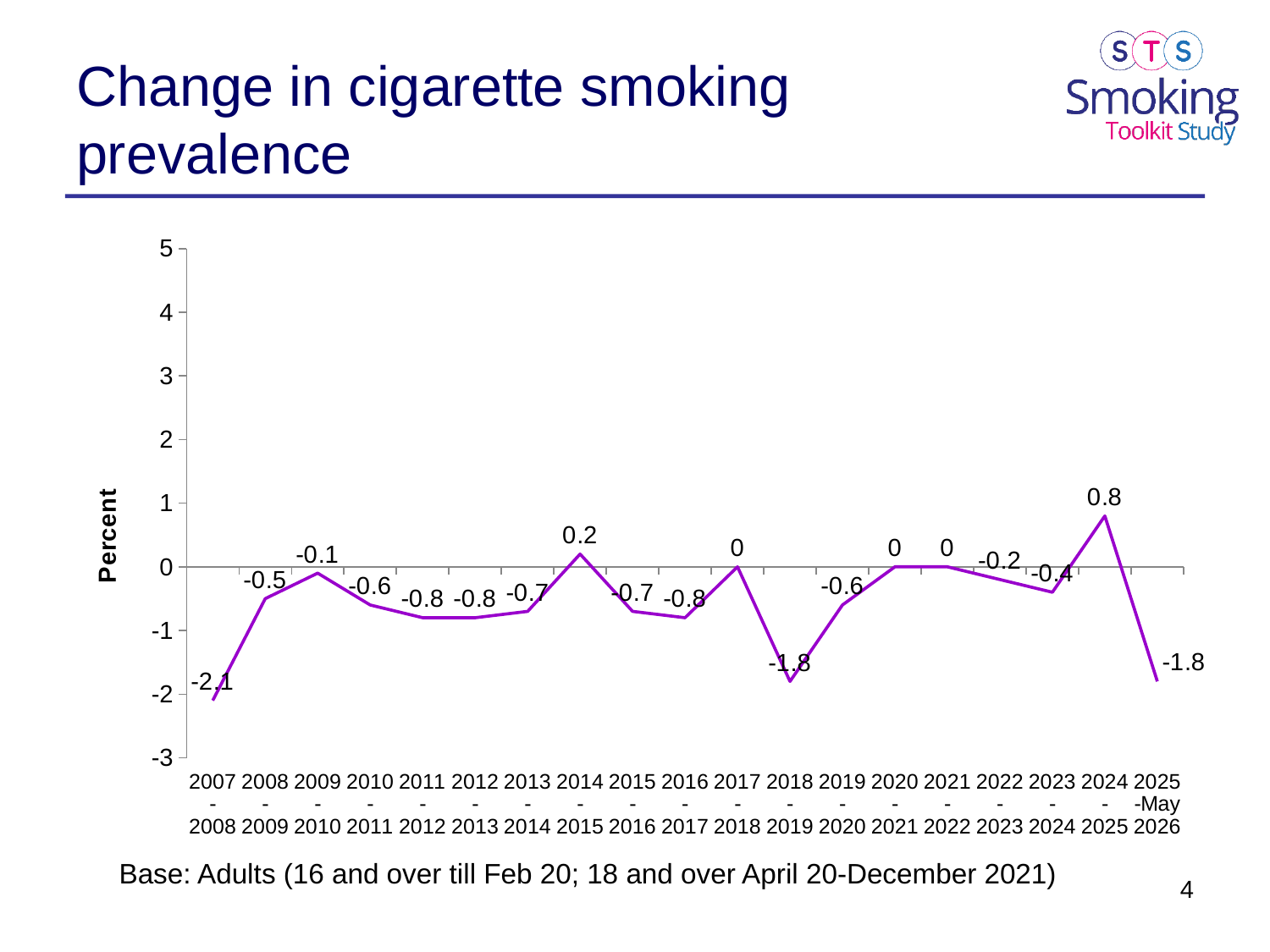
What is the label of the y axis? Percent What is the difference between the values for 2024-2025 and 2025-May 2026? 2.6 Which period has the lowest value? 2007-2008 What is the value for 2024-2025? 0.8 What is the title of the slide? Change in cigarette smoking prevalence What type of chart is shown on the slide? line chart What is the value for 2014-2015? 0.2 What is the value for 2018-2019? -1.8 What is the value for 2007-2008? -2.1 Which is larger, the value for 2009-2010 or the value for 2010-2011? 2009-2010 Which period has the highest value? 2024-2025 How many periods are plotted on the x axis? 19